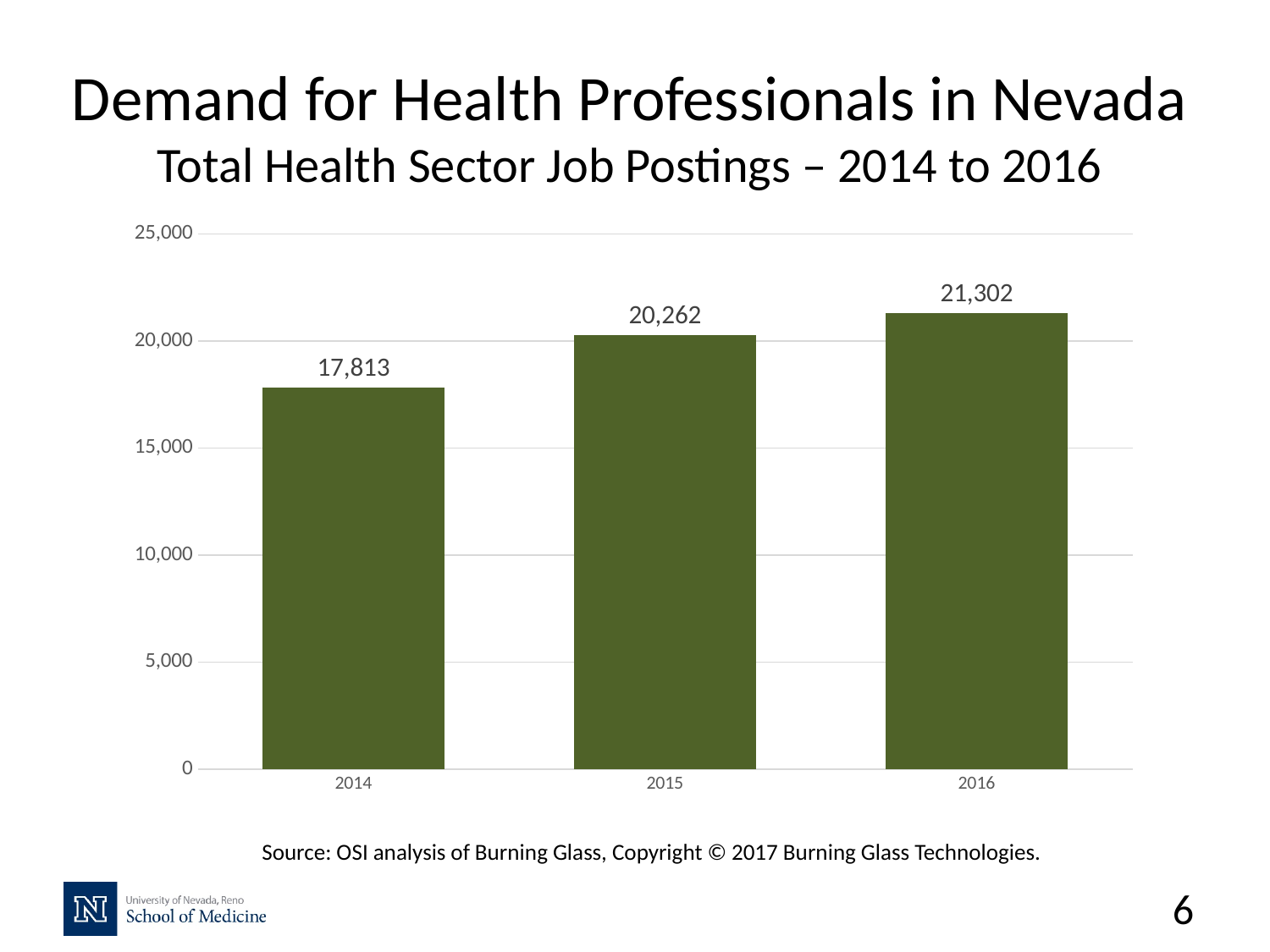
What kind of chart is shown on the slide? bar chart Which is larger, the value for 2015 or the value for 2014? 2015 How many years are shown on the x axis? 3 What is the value for 2014? 17,813 What is the difference between the values for 2015 and 2014? 2,449 What is the difference between the values for 2016 and 2014? 3,489 Is the value for 2014 greater or less than 20,000? less Which year has the lowest number of job postings? 2014 What is the value for 2015? 20,262 Which year has the highest number of job postings? 2016 Do the values rise or fall from 2014 to 2016? rise What is the value for 2016? 21,302